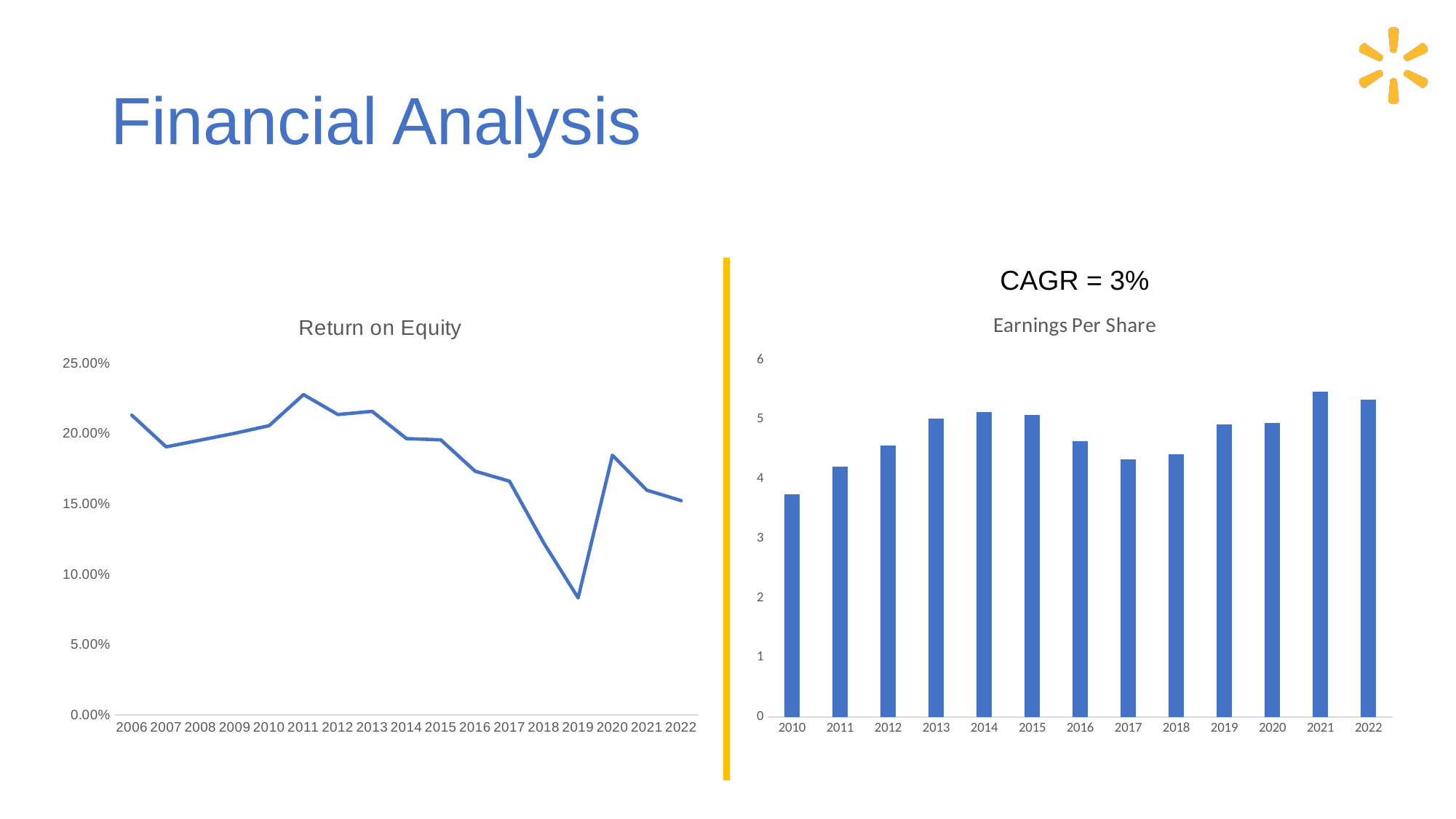
In the Return on Equity chart, is the value for 2018 greater or less than 15.00%? less In the Earnings Per Share chart, is the value for 2010 greater or less than 4? less In the Return on Equity chart, which year has the highest value? 2011 What CAGR is stated above the Earnings Per Share chart? 3% In the Earnings Per Share chart, which is larger, the value for 2013 or the value for 2017? 2013 In the Return on Equity chart, is the value for 2019 greater or less than 10.00%? less How many years are plotted in the Return on Equity chart? 17 What type of chart is the Earnings Per Share chart? bar chart In the Return on Equity chart, which year has the lowest value? 2019 In the Earnings Per Share chart, which year has the lowest bar? 2010 What type of chart is the Return on Equity chart? line chart